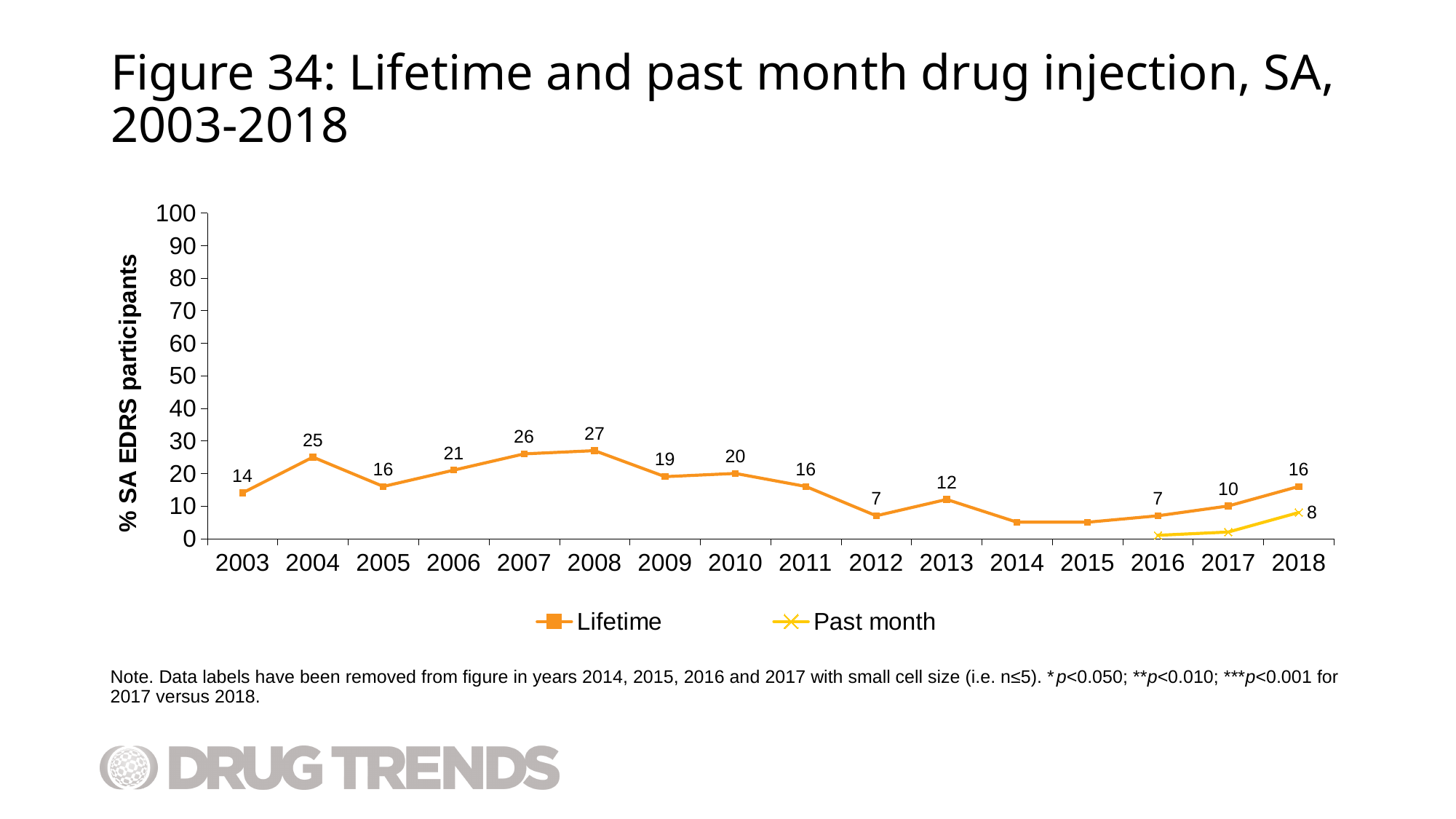
What is the difference between the Lifetime values for 2004 and 2005? 9 What is the y-axis label of the chart? % SA EDRS participants In which year is the Lifetime series highest? 2008 What kind of chart is shown? line chart Is the Lifetime value for 2014 greater or less than 10? less How many series does the legend list? 2 How many years are shown on the x axis? 16 What is the Lifetime value for 2008? 27 Does the Lifetime series rise or fall from 2016 to 2018? rise What is the Past month value for 2018? 8 Which is larger, the Lifetime value for 2007 or for 2009? 2007 What is the Lifetime value for 2003? 14